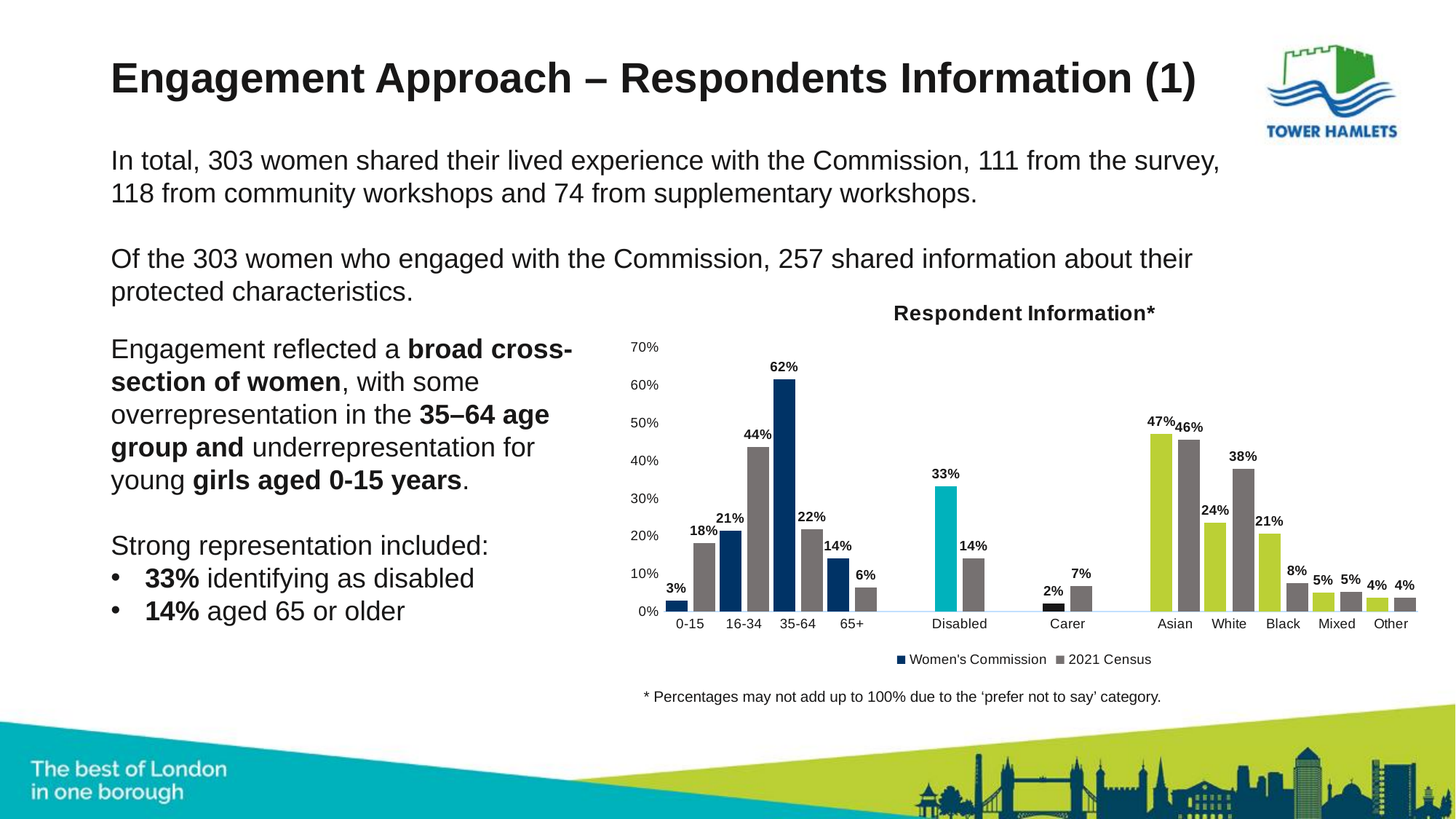
What is the Women's Commission value for Disabled? 33% What is the difference between the Women's Commission and 2021 Census values for Black? 13% What is the 2021 Census value for the 16-34 age group? 44% How many categories are shown on the x axis of the chart? 11 Which category has the lowest Women's Commission value? Carer What is the Women's Commission value for the 35-64 age group? 62% What kind of chart is shown on the slide? Bar chart How many series does the chart legend list? 2 What is the title of the chart? Respondent Information* Which is larger for the 0-15 age group: the Women's Commission value or the 2021 Census value? 2021 Census Which category has the highest Women's Commission value? 35-64 What is the 2021 Census value for White? 38%